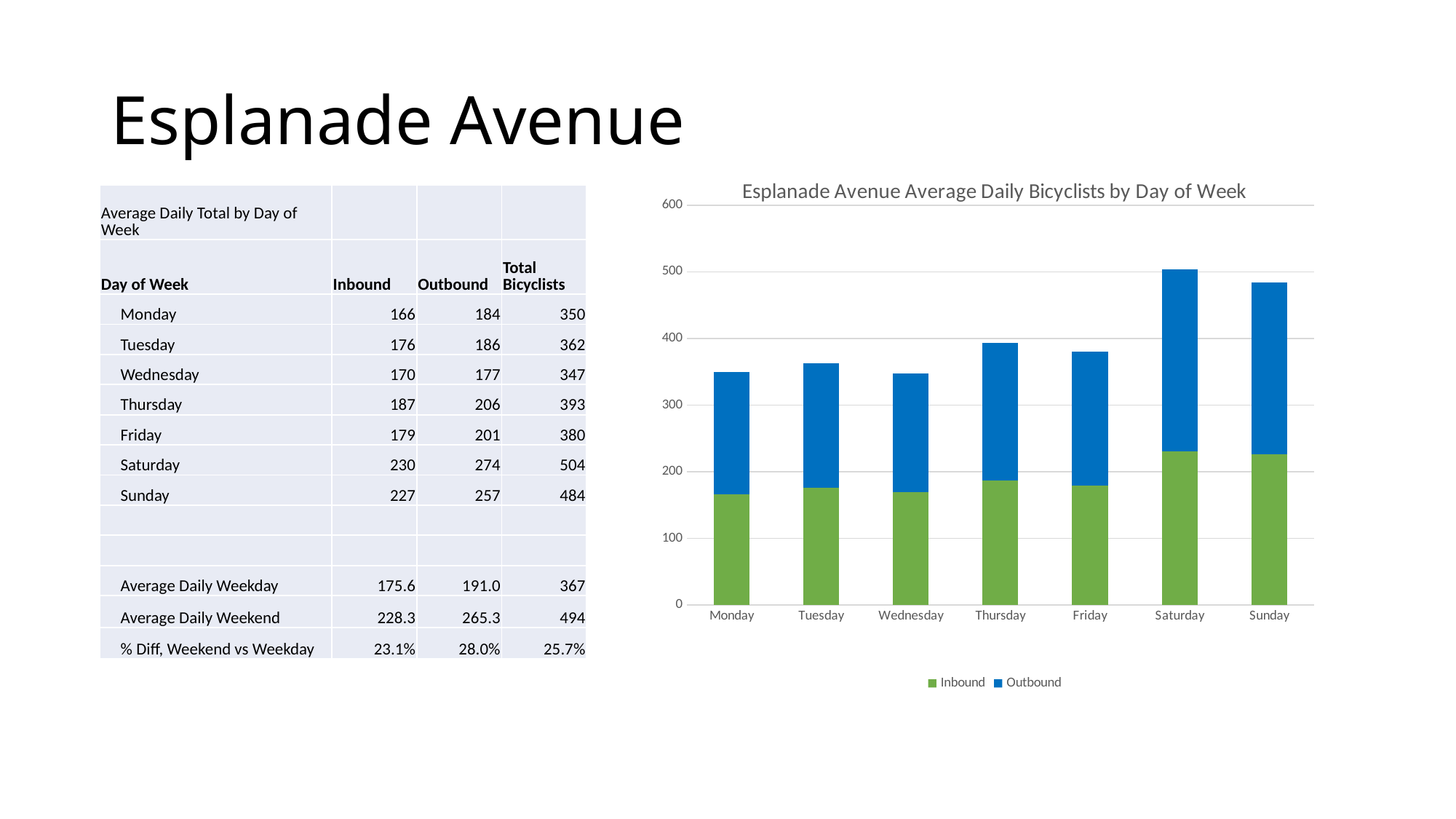
How many series does the chart legend list? 2 According to the slide, what is the total number of bicyclists for Sunday (Inbound plus Outbound)? 484 Which colour represents the Outbound series in the chart? Blue Which day has the highest total stacked bar in the chart? Saturday What kind of chart is shown on the slide? Stacked bar chart Which day has the lowest total stacked bar in the chart? Wednesday How many days of the week are plotted on the x axis of the chart? 7 Which is larger, the total bar for Thursday or the total bar for Friday? Thursday According to the slide, what is the Inbound value for Saturday? 230 Is the Inbound value for Monday greater or less than 200? less Is the total bar for Saturday greater or less than 500? greater What is the title of the chart? Esplanade Avenue Average Daily Bicyclists by Day of Week